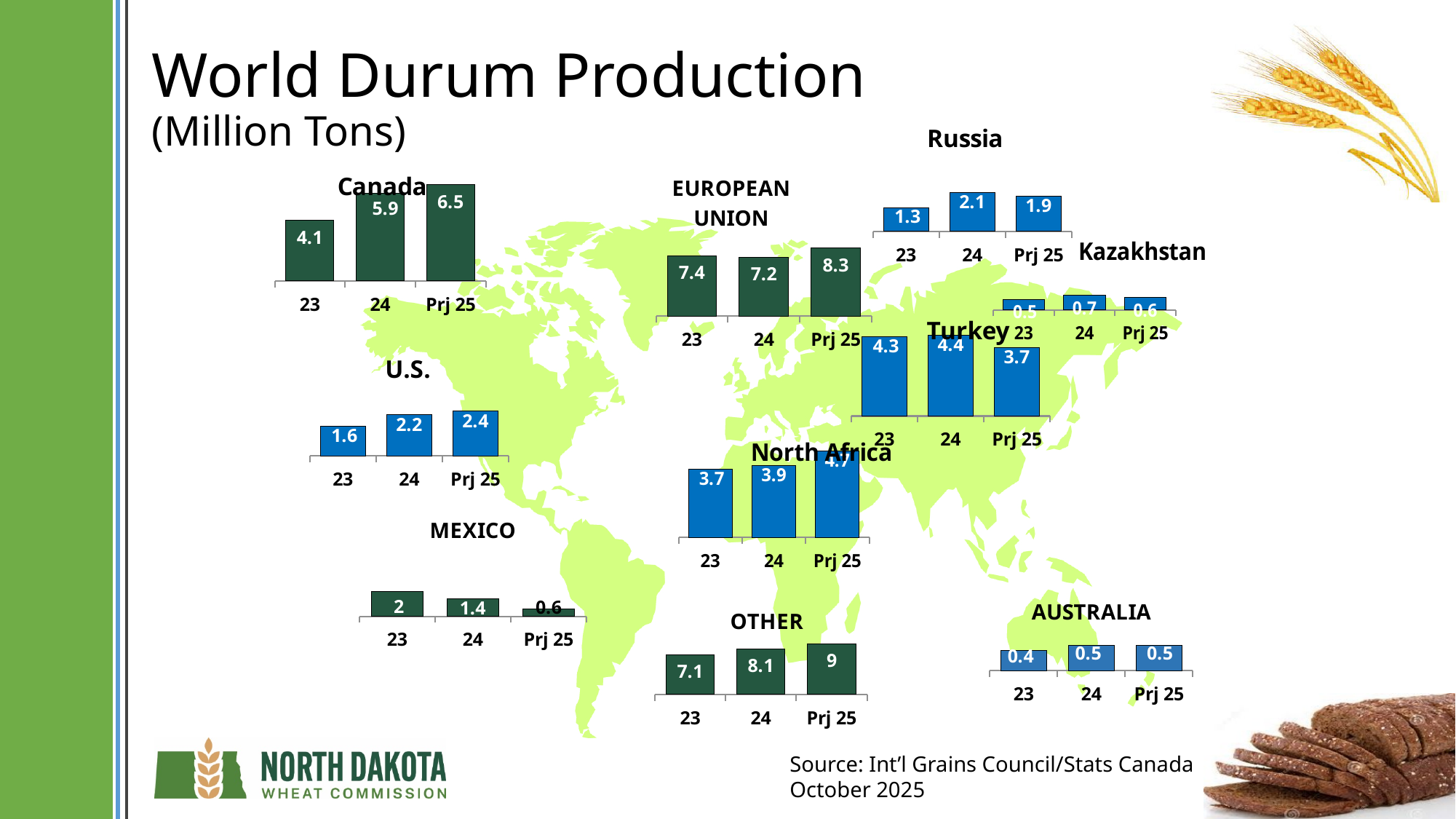
In the Other chart, do the values rise or fall from 23 to Prj 25? rise In the U.S. chart, how many bars are plotted? 3 In the Australia chart, what is the value for 23? 0.4 In the Mexico chart, which year has the lowest value? Prj 25 In the Canada chart, what is the value for Prj 25? 6.5 In the Russia chart, which year has the highest value? 24 What unit is stated under the slide title for the charts? Million Tons In the Turkey chart, which is larger, the value for 23 or the value for Prj 25? 23 What kind of chart is used for the Other chart? bar chart In the Canada chart, what is the difference between the values for 24 and 23? 1.8 In the European Union chart, what is the value for 24? 7.2 In the Kazakhstan chart, what is the value for 24? 0.7